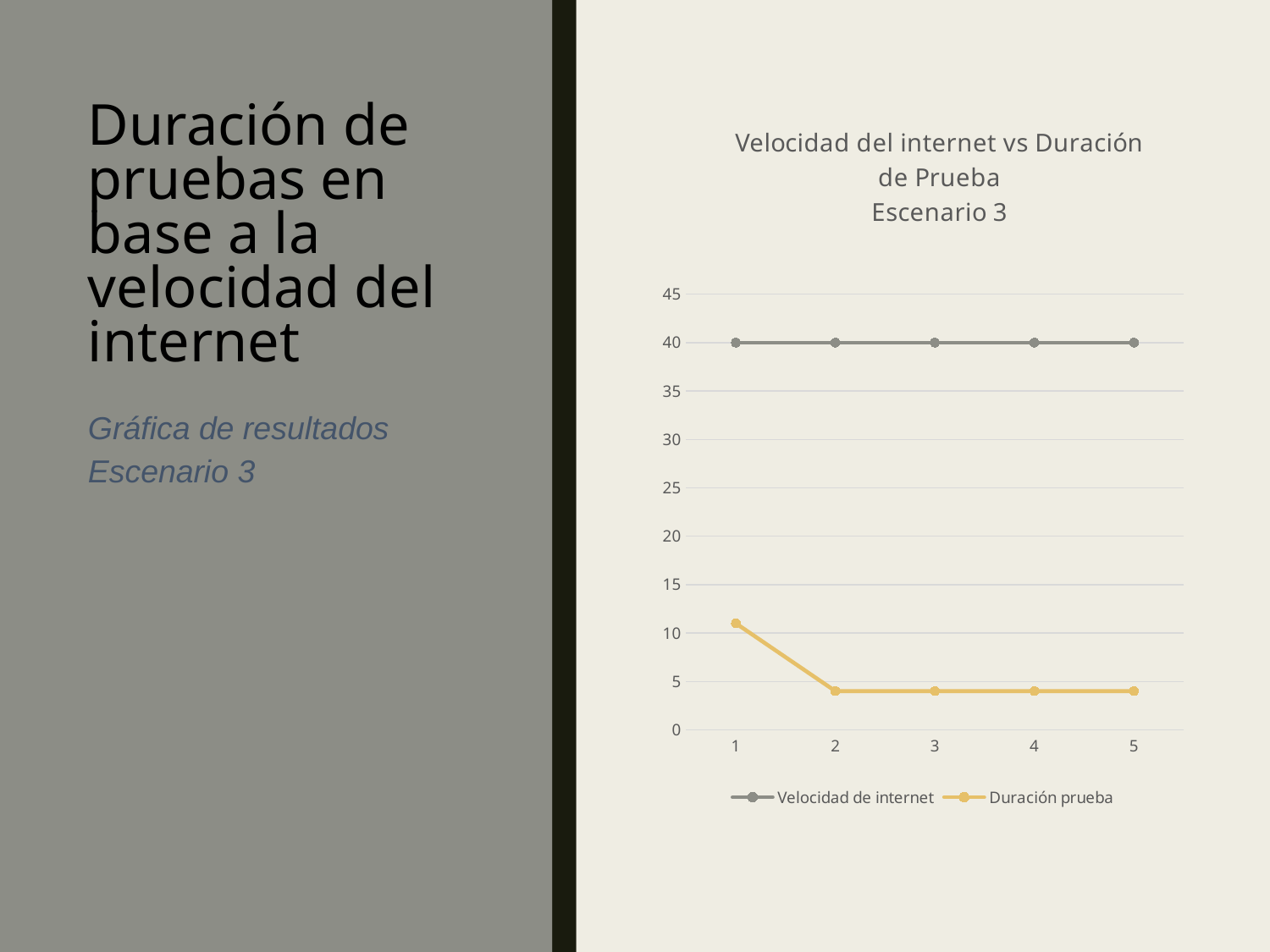
At which x-axis point is Duración prueba highest? 1 How many points are plotted along the x axis for each series? 5 Is the value of Duración prueba at point 1 greater or less than 15? less How many series does the legend list? 2 What is the value of Velocidad de internet at point 3? 40 What is the value of Velocidad de internet at point 1? 40 Does the Duración prueba series rise or fall from point 1 to point 2? fall What is the title of the chart? Velocidad del internet vs Duración de Prueba Escenario 3 Is the value of Duración prueba at point 1 greater or less than 10? greater What kind of chart is shown on the slide? line chart Which series has the higher value at point 2, Velocidad de internet or Duración prueba? Velocidad de internet Is the value of Duración prueba at point 4 greater or less than 5? less